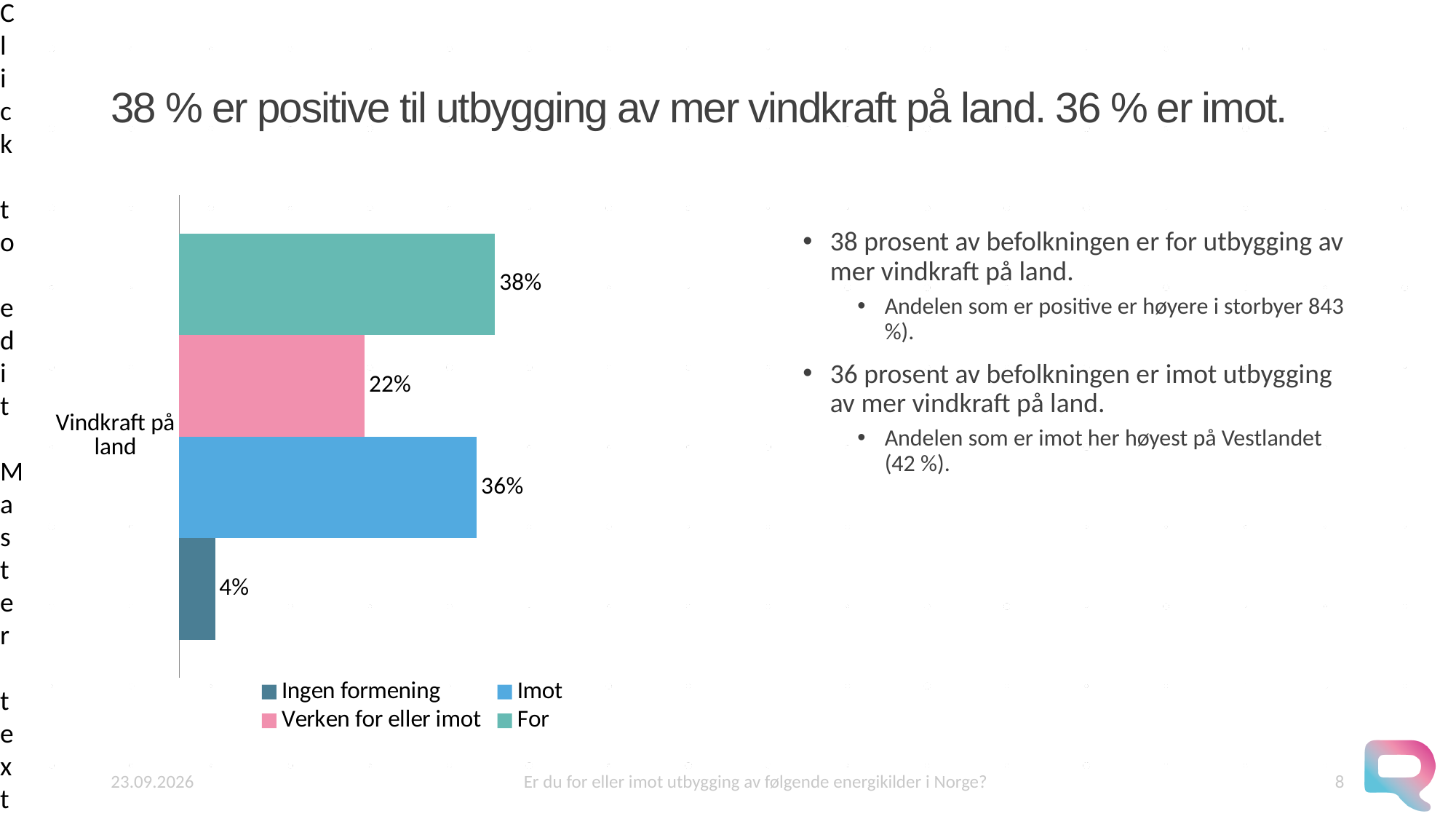
Which series has the highest value for Vindkraft på land? For Which series has the lowest value for Vindkraft på land? Ingen formening What is the value for the 'For' series for Vindkraft på land? 38% What is the value for 'Ingen formening' for Vindkraft på land? 4% How many series does the legend list? 4 What is the difference between the 'For' and 'Imot' values for Vindkraft på land? 2% What is the difference between the 'Verken for eller imot' and 'Ingen formening' values? 18% What is the value for 'Verken for eller imot' for Vindkraft på land? 22% What is the category label shown on the chart's axis? Vindkraft på land What kind of chart is shown on the slide? Bar chart Which is larger for Vindkraft på land: 'Imot' or 'Verken for eller imot'? Imot What is the value for the 'Imot' series for Vindkraft på land? 36%